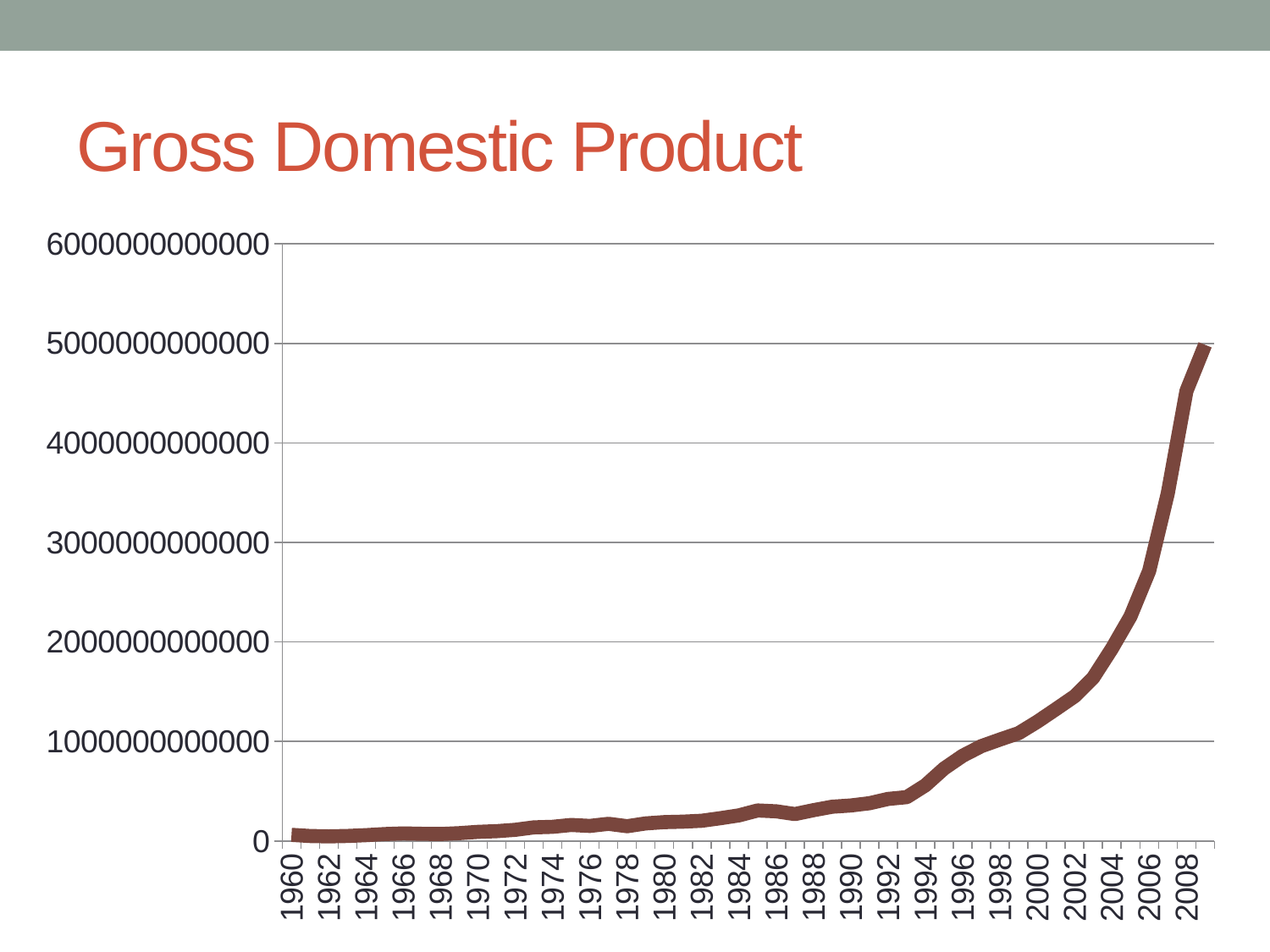
How many year labels are shown on the x axis? 25 Which year has the larger value, 1998 or 2002? 2002 What kind of chart is shown on the slide? line chart Is the value for 2006 greater or less than 3000000000000? less What is the highest value shown on the y axis? 6000000000000 Is the value for 2008 greater or less than 4000000000000? greater Is the value for 2008 greater or less than 5000000000000? less Do the values generally rise or fall from 1960 to 2008? rise What is the title of the chart? Gross Domestic Product Which year has the larger value, 1990 or 2008? 2008